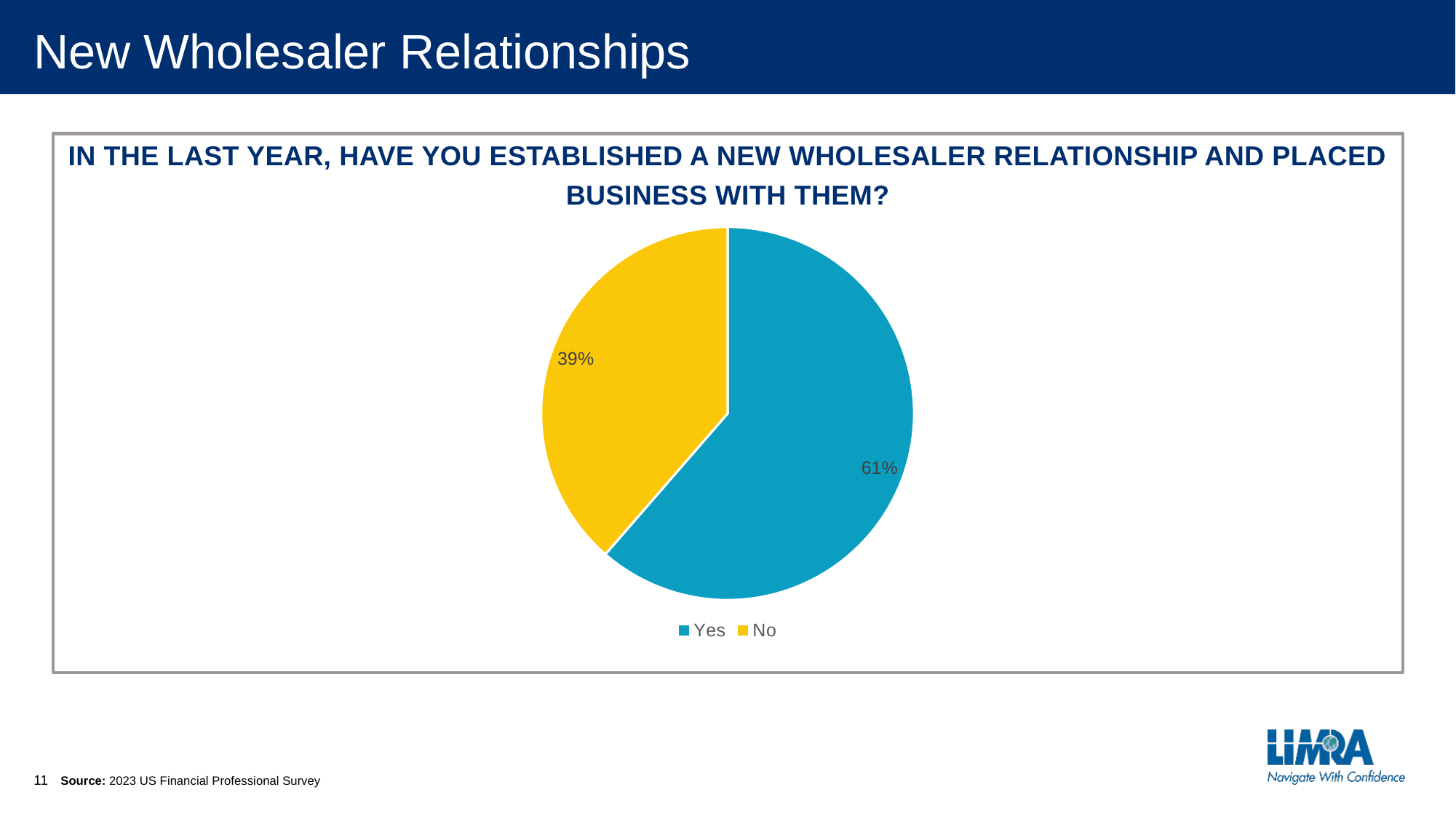
Is the share for Yes larger or smaller than the share for No? larger Which colour represents the Yes response in the pie chart? blue How many slices does the pie chart have? 2 How many entries does the legend list? 2 What percentage of respondents answered Yes? 61% What is the difference in percentage points between the Yes and No shares? 22 What percentage of respondents answered No? 39% What kind of chart is shown on the slide? pie chart What share of the pie does the No slice represent? 39% What is the source cited for the chart data? 2023 US Financial Professional Survey Which response has the larger share of the pie? Yes Which response has the smaller share of the pie? No